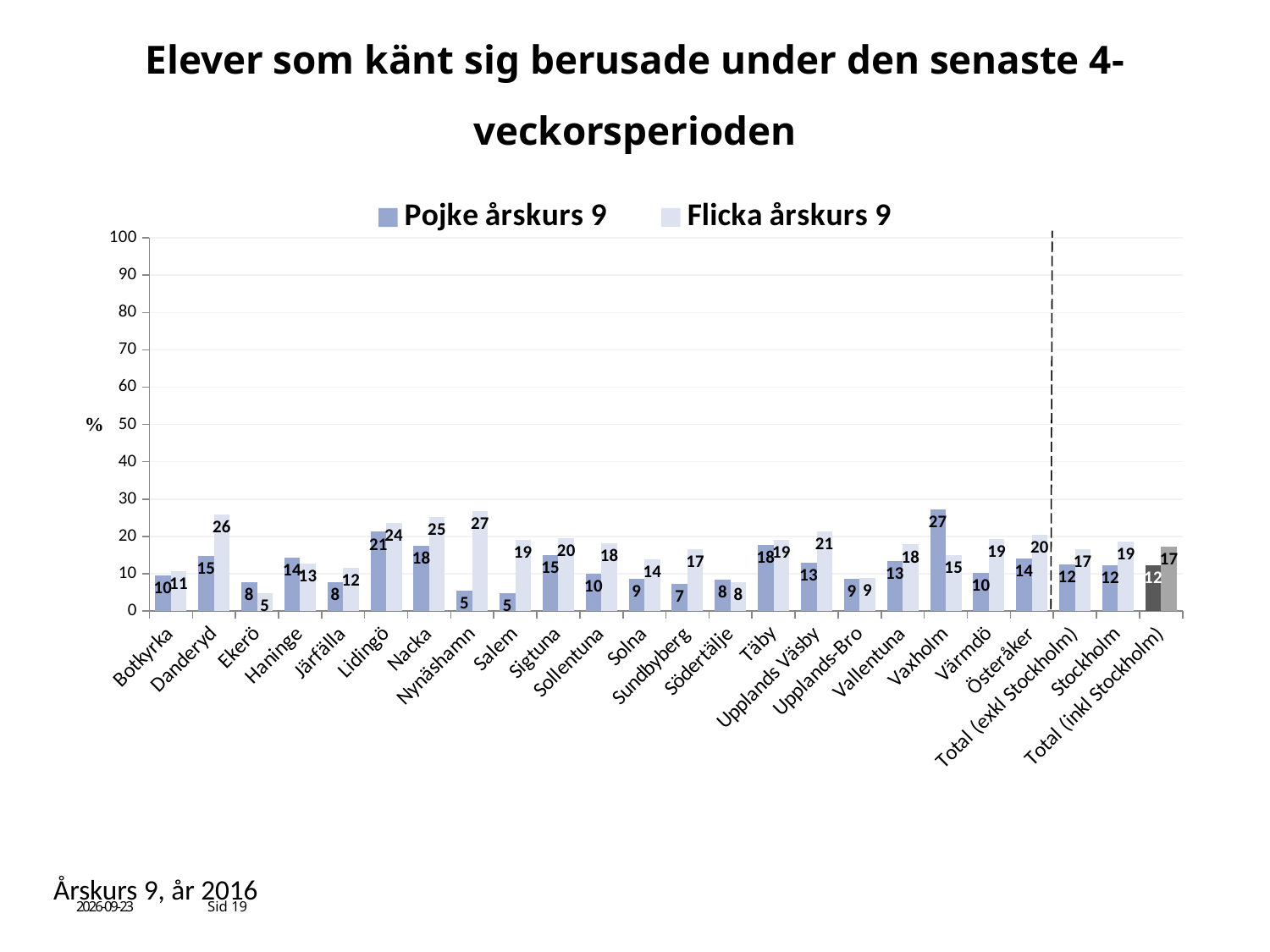
What kind of chart is shown on the slide? Bar chart How many categories are shown on the x axis? 24 What is the difference between the Flicka årskurs 9 and Pojke årskurs 9 values in Salem? 14 Is the value for Flicka årskurs 9 in Danderyd greater or less than 20? greater Which is larger in Vaxholm: the Pojke årskurs 9 value or the Flicka årskurs 9 value? Pojke årskurs 9 How many series does the legend list? 2 What is the value for Flicka årskurs 9 in Nynäshamn? 27 Which category has the lowest value for Flicka årskurs 9? Ekerö Which category has the highest value for Pojke årskurs 9? Vaxholm What is the value for Pojke årskurs 9 in Danderyd? 15 What is the title of the chart? Elever som känt sig berusade under den senaste 4-veckorsperioden What is the value for Flicka årskurs 9 in Stockholm? 19